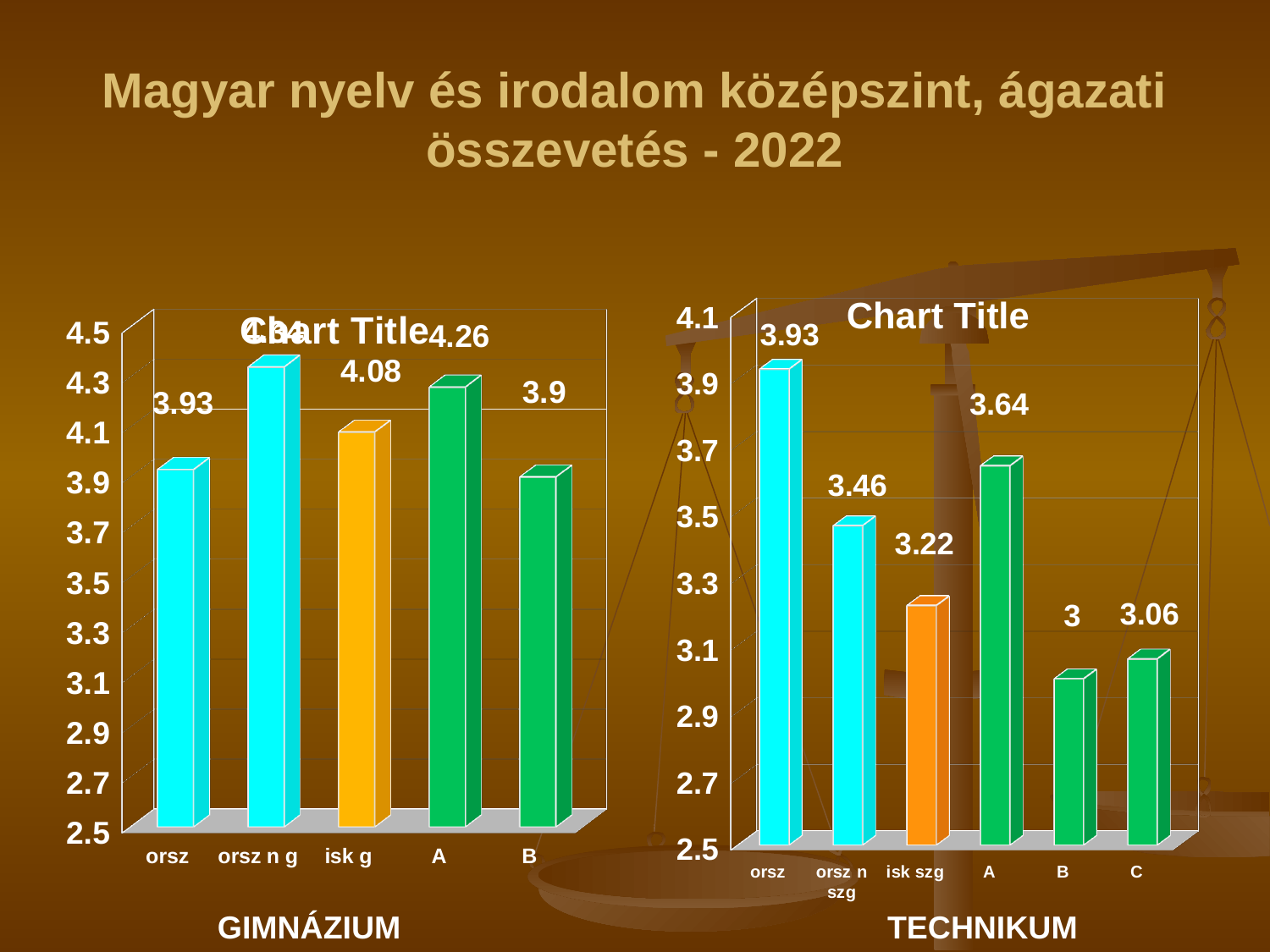
In the TECHNIKUM chart on the right, what is the value for isk szg? 3.22 What kind of chart is the GIMNÁZIUM chart on the left? bar chart In the GIMNÁZIUM chart on the left, what is the value for isk g? 4.08 In the TECHNIKUM chart on the right, what is the value for A? 3.64 In the TECHNIKUM chart on the right, what is the difference between the values for orsz and orsz n szg? 0.47 In the TECHNIKUM chart on the right, which category has the lowest value? B How many categories are shown in the TECHNIKUM chart on the right? 6 In the GIMNÁZIUM chart on the left, which is larger, the value for A or the value for B? A In the TECHNIKUM chart on the right, which category has the highest value? orsz In the GIMNÁZIUM chart on the left, what is the value for A? 4.26 In the GIMNÁZIUM chart on the left, what is the difference between the values for A and isk g? 0.18 How many categories are shown in the GIMNÁZIUM chart on the left? 5